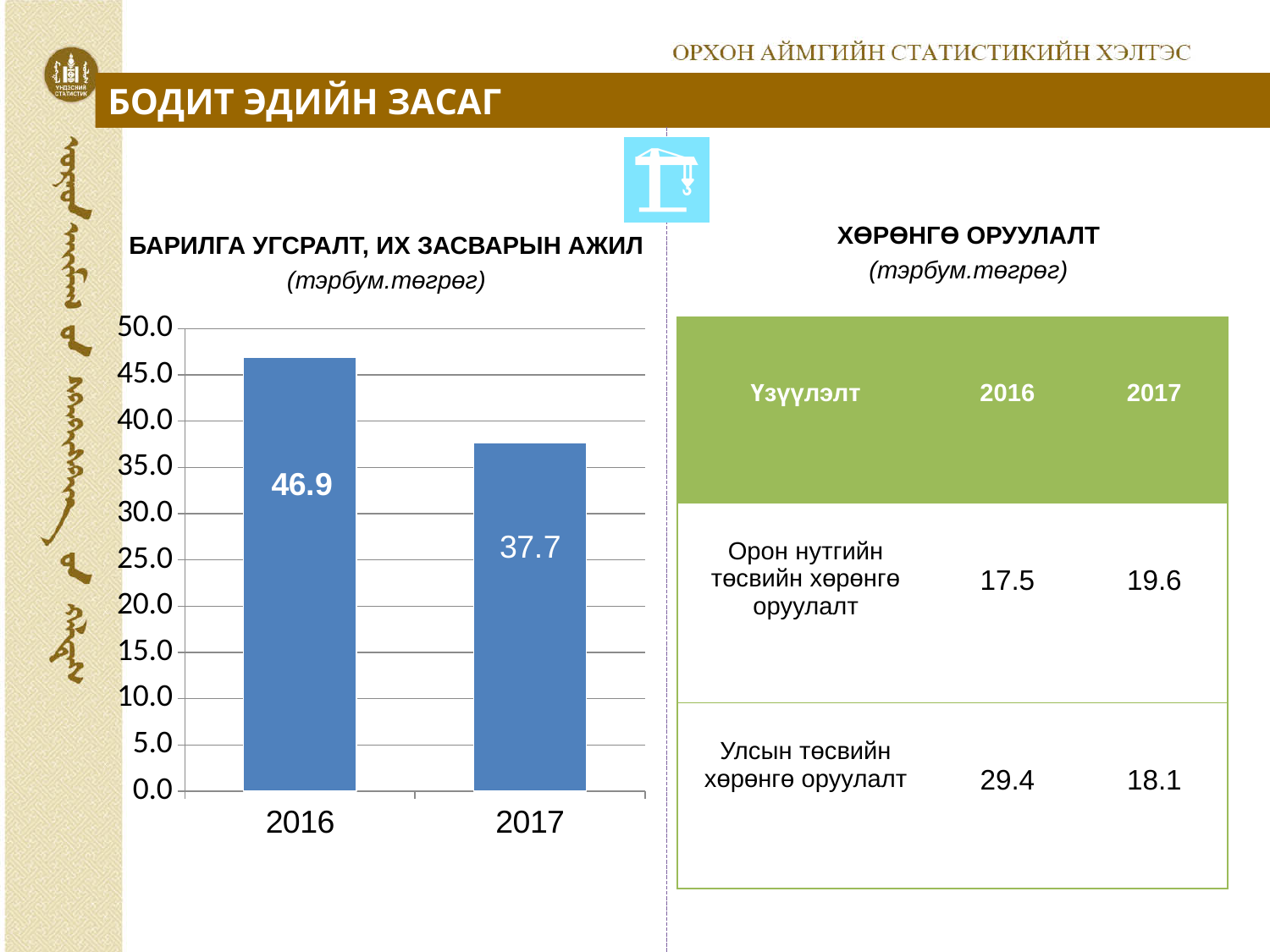
What kind of chart is shown on the slide? bar chart Is the value for 2017 in the bar chart greater or less than 40.0? less What is the value for 2016 in the bar chart? 46.9 Which is larger in the bar chart, the value for 2016 or the value for 2017? 2016 How many bars are shown in the chart? 2 Do the values in the bar chart rise or fall from 2016 to 2017? fall What is the title of the bar chart? БАРИЛГА УГСРАЛТ, ИХ ЗАСВАРЫН АЖИЛ What is the value for 2017 in the bar chart? 37.7 Is the value for 2016 in the bar chart greater or less than 45.0? greater What is the difference between the 2016 and 2017 values in the bar chart? 9.2 Which year has the highest value in the bar chart? 2016 Which year has the lowest value in the bar chart? 2017